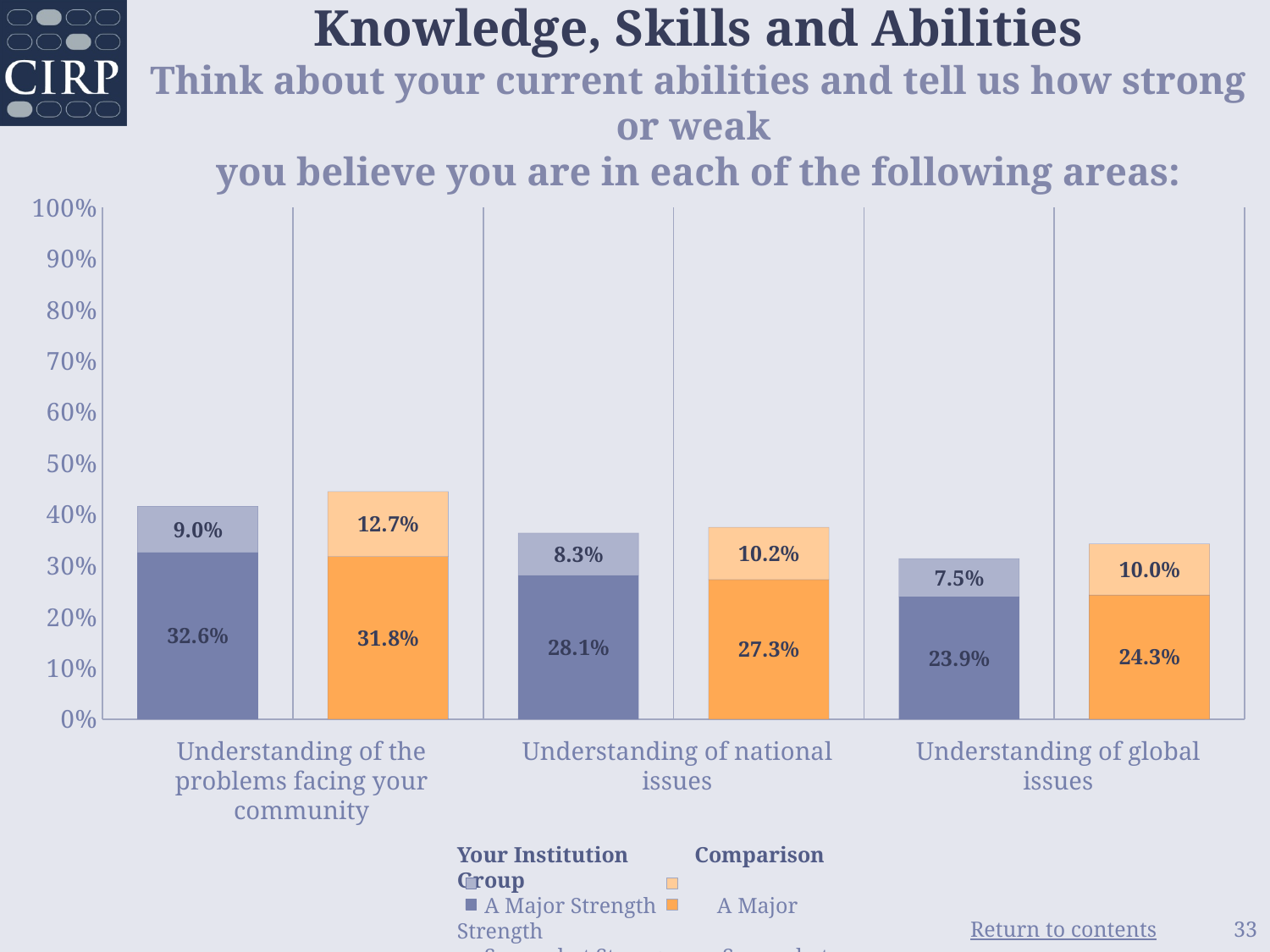
What is the 'A Major Strength' value for Your Institution for 'Understanding of the problems facing your community'? 9.0% What is the difference between the Your Institution and Comparison Group 'A Major Strength' values for 'Understanding of national issues'? 1.9% For 'Understanding of the problems facing your community', which is larger: the Your Institution 'A Major Strength' value or the Comparison Group 'A Major Strength' value? Comparison Group (12.7%) What kind of chart is shown on the slide? Stacked bar chart Which category has the highest 'A Major Strength' value for Your Institution? Understanding of the problems facing your community Which category has the lowest 'A Major Strength' value for the Comparison Group? Understanding of global issues How many categories are shown on the x axis of the chart? 3 What is the total height of the Your Institution stacked bar for 'Understanding of global issues'? 31.4% What is the value of the lighter top segment of the Your Institution bar for 'Understanding of global issues'? 7.5% What is the 'A Major Strength' value for the Comparison Group for 'Understanding of global issues'? 10.0% What is the value of the lighter top segment of the Comparison Group bar for 'Understanding of national issues'? 10.2% What is the total height of the Comparison Group stacked bar for 'Understanding of the problems facing your community'? 44.5%